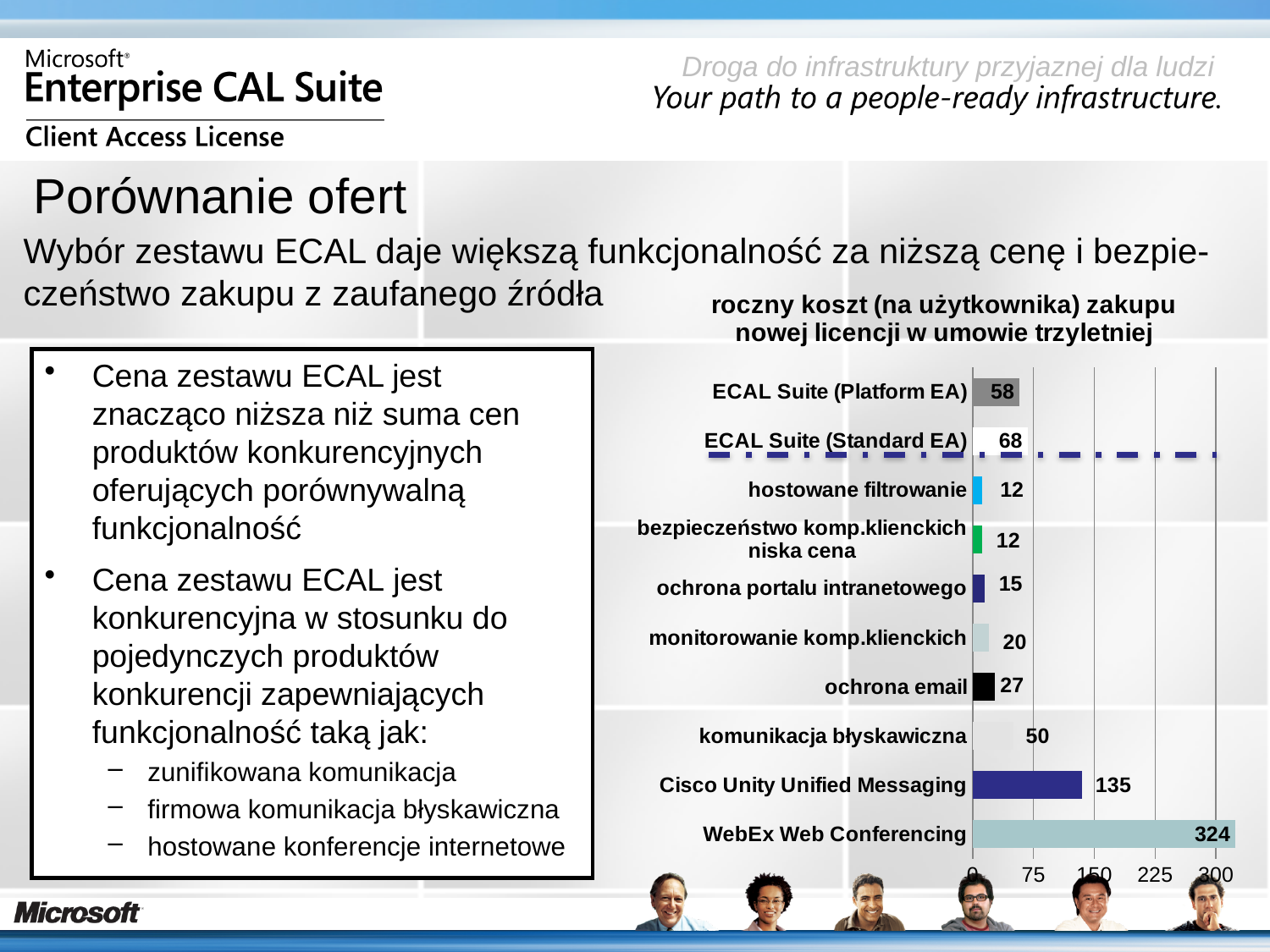
Which category has the highest value? WebEx Web Conferencing What kind of chart is shown on the slide? bar chart What is the difference between the values for ECAL Suite (Standard EA) and ECAL Suite (Platform EA)? 10 What is the value for ochrona email? 27 What is the title of the chart? roczny koszt (na użytkownika) zakupu nowej licencji w umowie trzyletniej What is the value for WebEx Web Conferencing? 324 What is the difference between the values for WebEx Web Conferencing and Cisco Unity Unified Messaging? 189 Which is larger, the value for komunikacja błyskawiczna or the value for ochrona email? komunikacja błyskawiczna Is the value for Cisco Unity Unified Messaging greater or less than 75? greater What is the value for Cisco Unity Unified Messaging? 135 What is the value for ECAL Suite (Platform EA)? 58 How many categories are shown in the chart? 10